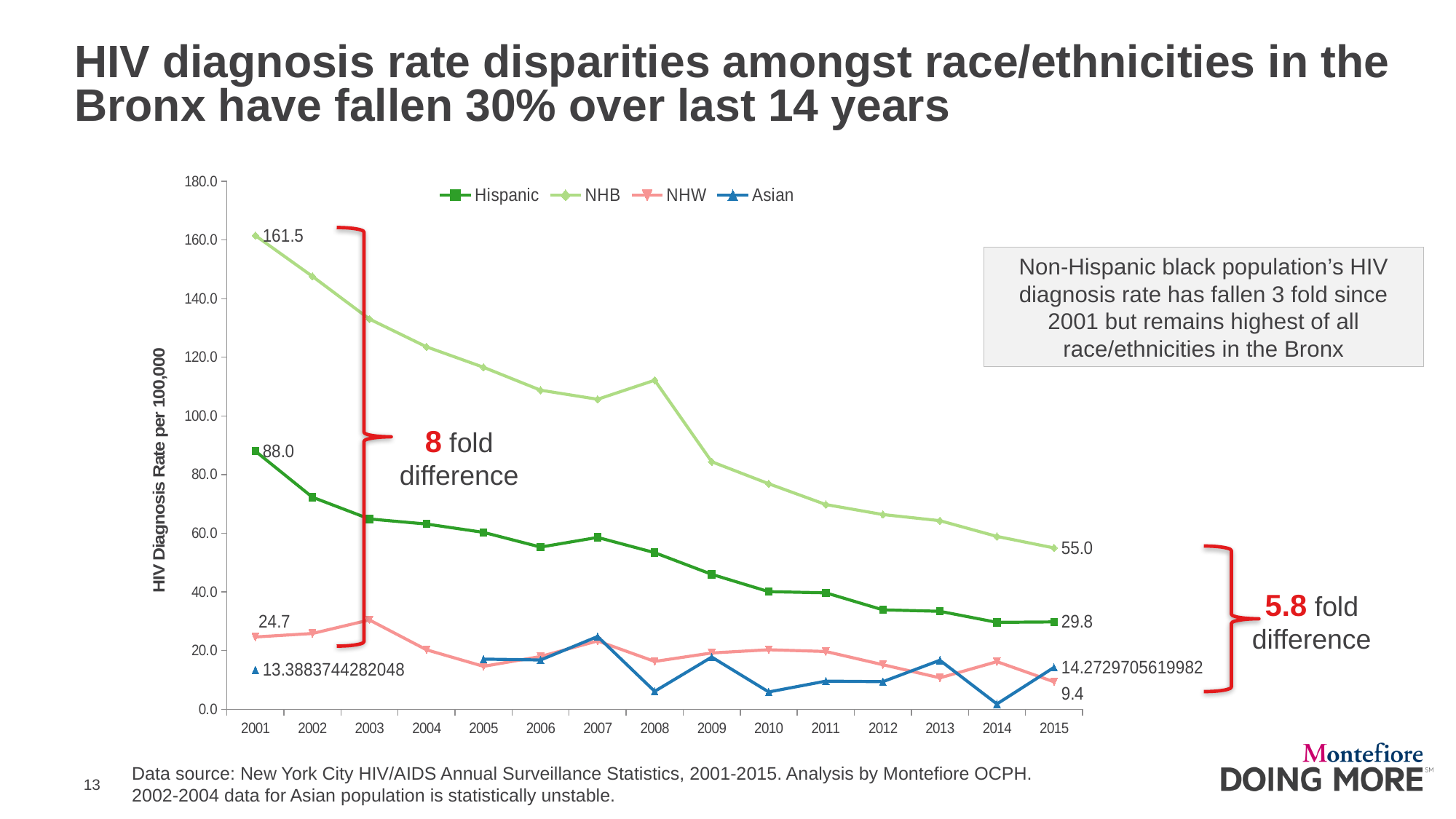
Is the NHB value for 2008 greater or less than 100.0? greater Which race/ethnicity has the lowest HIV diagnosis rate in 2001? Asian How many years are shown on the x axis? 15 What is the HIV diagnosis rate for Hispanic in 2015? 29.8 By how much did the NHB HIV diagnosis rate fall from 2001 to 2015? 106.5 What is the HIV diagnosis rate for NHW in 2001? 24.7 What is the HIV diagnosis rate for NHB in 2015? 55.0 What kind of chart is shown on the slide? Line chart How many series does the legend list? 4 What is the HIV diagnosis rate for NHB in 2001? 161.5 What is the difference between the Hispanic rate in 2001 and in 2015? 58.2 Which race/ethnicity has the highest HIV diagnosis rate in 2015? NHB